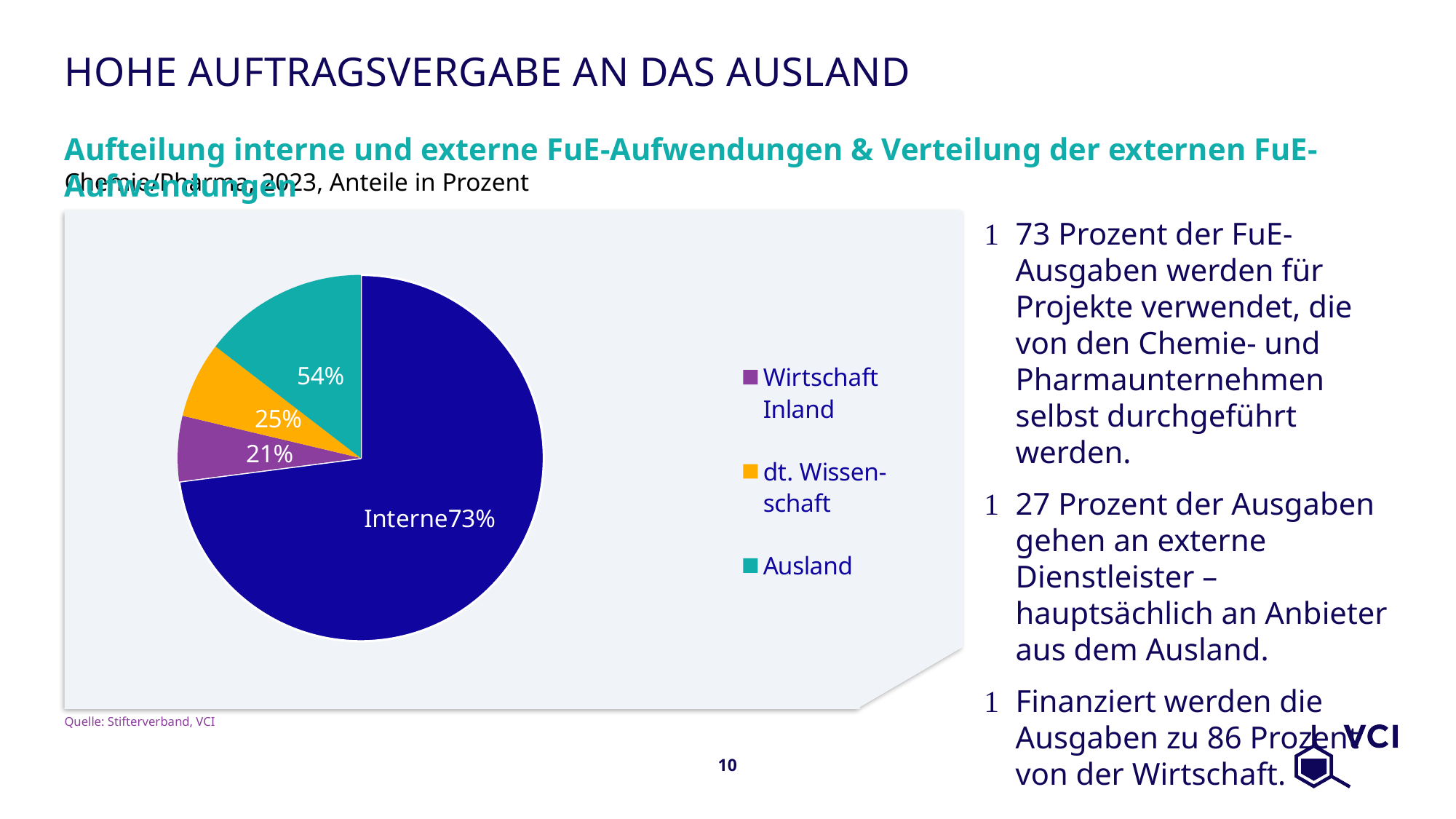
Which slice is larger in the pie chart, Ausland or dt. Wissenschaft? Ausland How many slices does the pie chart have? 4 How many entries does the legend of the pie chart list? 3 Which slice of the pie chart is the smallest? Wirtschaft Inland Which slice of the pie chart is the largest? Interne What percentage label is printed on the dt. Wissenschaft slice of the pie chart? 25% What percentage label is printed on the Interne slice of the pie chart? 73% What percentage label is printed on the Wirtschaft Inland slice of the pie chart? 21% What percentage label is printed on the Ausland slice of the pie chart? 54% What kind of chart is shown on the slide? pie chart What colour is the Ausland slice in the pie chart? teal What is the difference between the labels printed on the Ausland slice and the Wirtschaft Inland slice? 33 percentage points